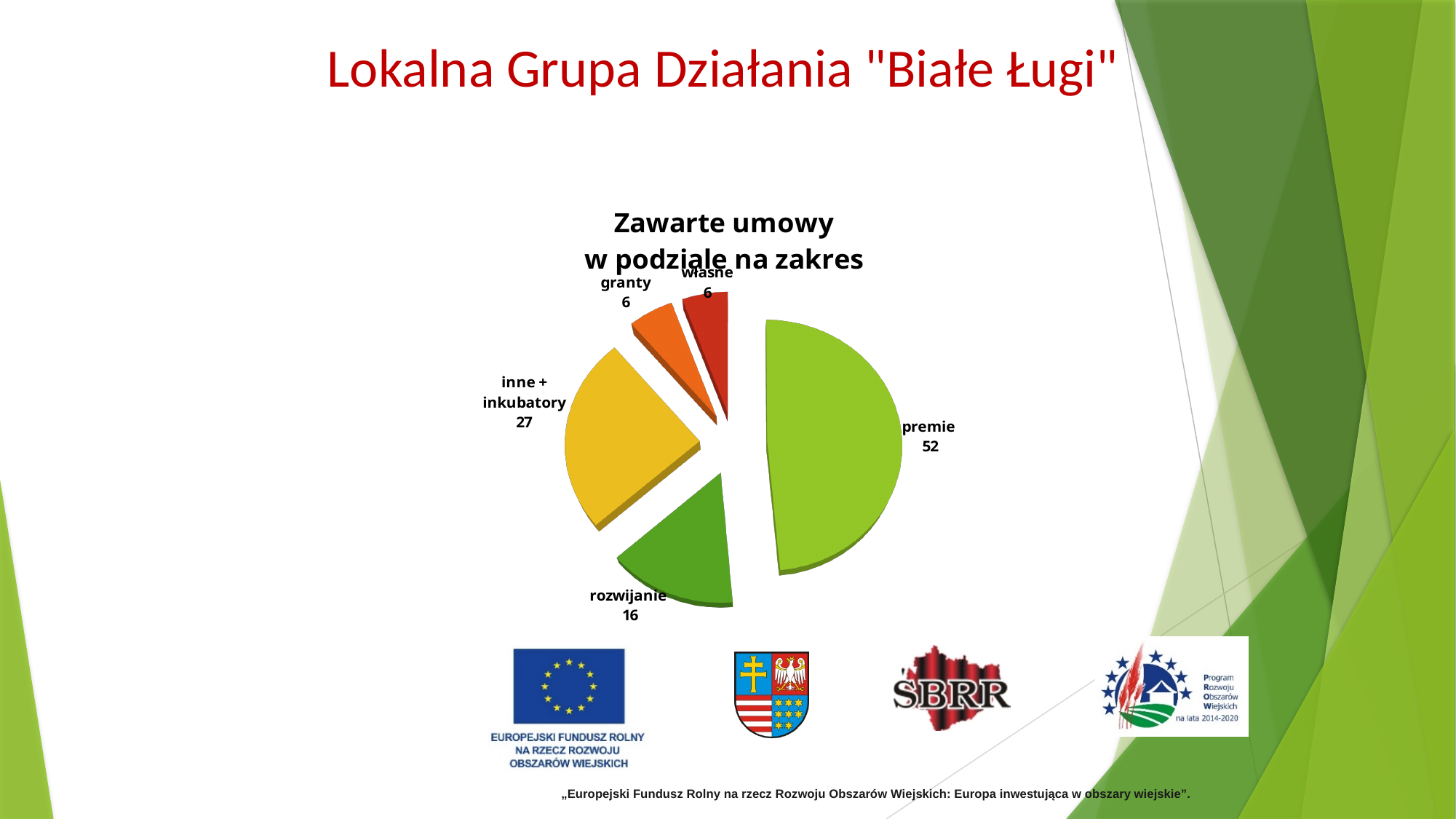
Which category has the largest slice? premie What is the difference between premie and inne + inkubatory? 25 What is the value for premie? 52 What is the value for inne + inkubatory? 27 What is the title of the chart? Zawarte umowy w podziale na zakres What is the value for rozwijanie? 16 Which is larger, rozwijanie or inne + inkubatory? inne + inkubatory What is the total of all slices in the pie chart? 107 What kind of chart is shown on the slide? pie chart How many slices does the pie chart have? 5 Which categories have the smallest value? granty and własne What is the value for granty? 6